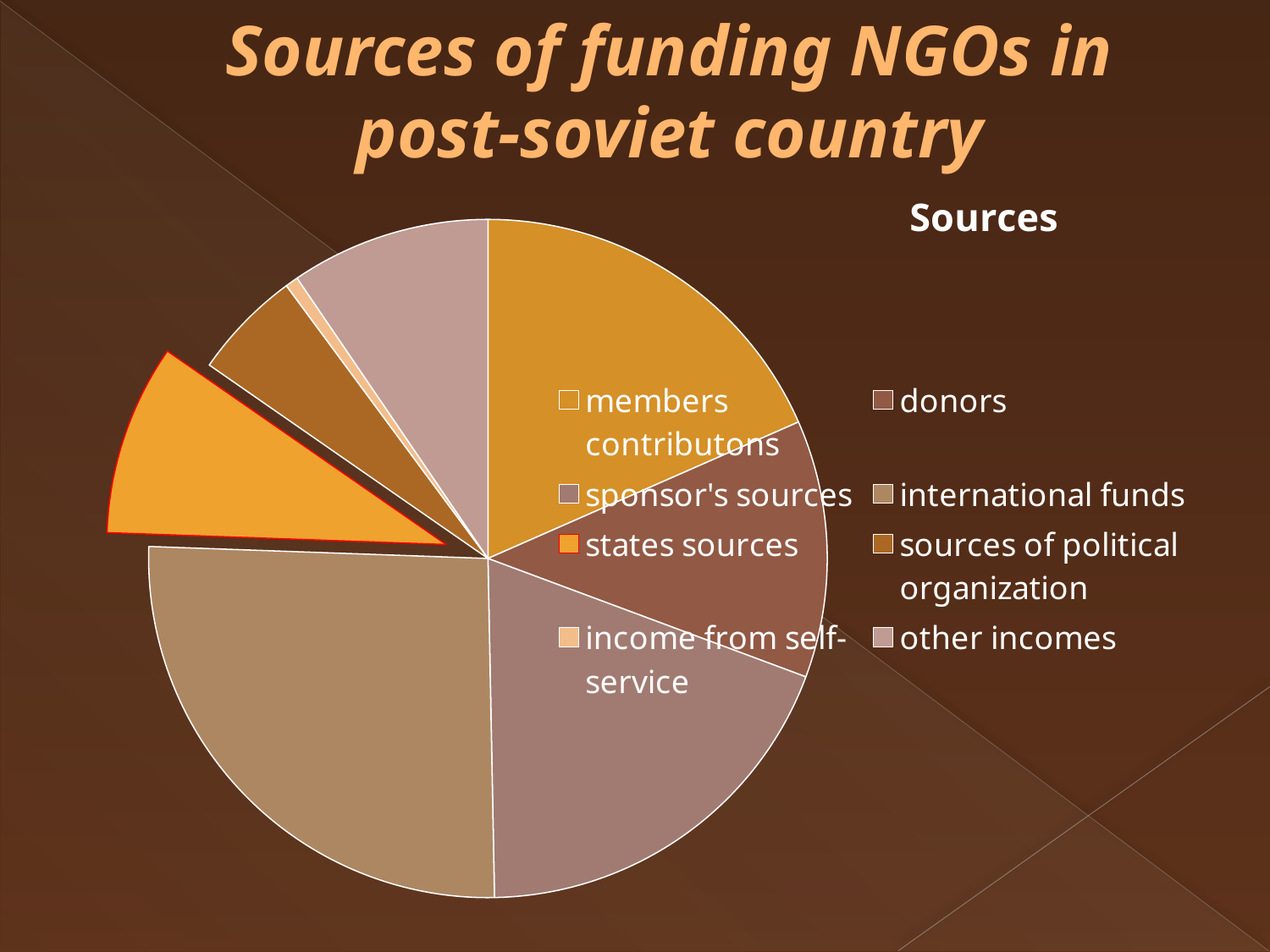
What is the title shown above the legend of the pie chart? Sources Which funding source has the largest slice of the pie chart? international funds How many entries does the legend of the pie chart list? 8 Which slice is larger: other incomes or sources of political organization? other incomes Which slice is larger: donors or income from self-service? donors Which funding source has the smallest slice of the pie chart? income from self-service How many slices does the pie chart have? 8 Which slice is larger: international funds or income from self-service? international funds What kind of chart is shown on the slide? pie chart Which slice of the pie chart is pulled out from the rest and outlined in red? states sources